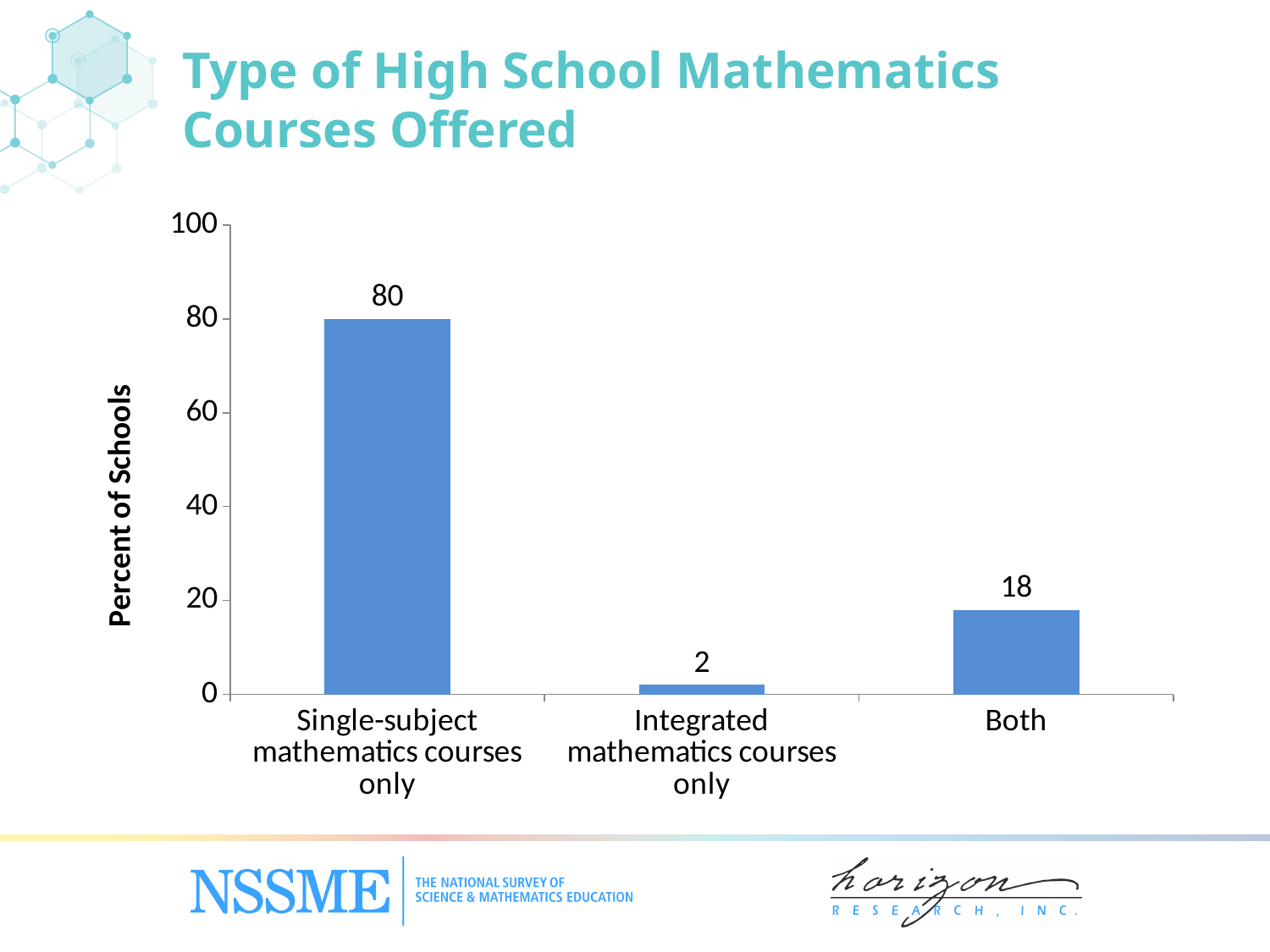
What is the difference in percent of schools between both and integrated mathematics courses only? 16 What kind of chart is shown on the slide? Bar chart What is the difference in percent of schools between single-subject mathematics courses only and both? 62 Which category has the highest percent of schools? Single-subject mathematics courses only What is the label of the vertical axis? Percent of Schools What percent of schools offer single-subject mathematics courses only? 80 What percent of schools offer integrated mathematics courses only? 2 Which is larger: the percent of schools offering both, or the percent offering integrated mathematics courses only? Both Is the value for single-subject mathematics courses only greater or less than 60? greater How many categories are shown on the chart? 3 Which category has the lowest percent of schools? Integrated mathematics courses only What percent of schools offer both types of mathematics courses? 18